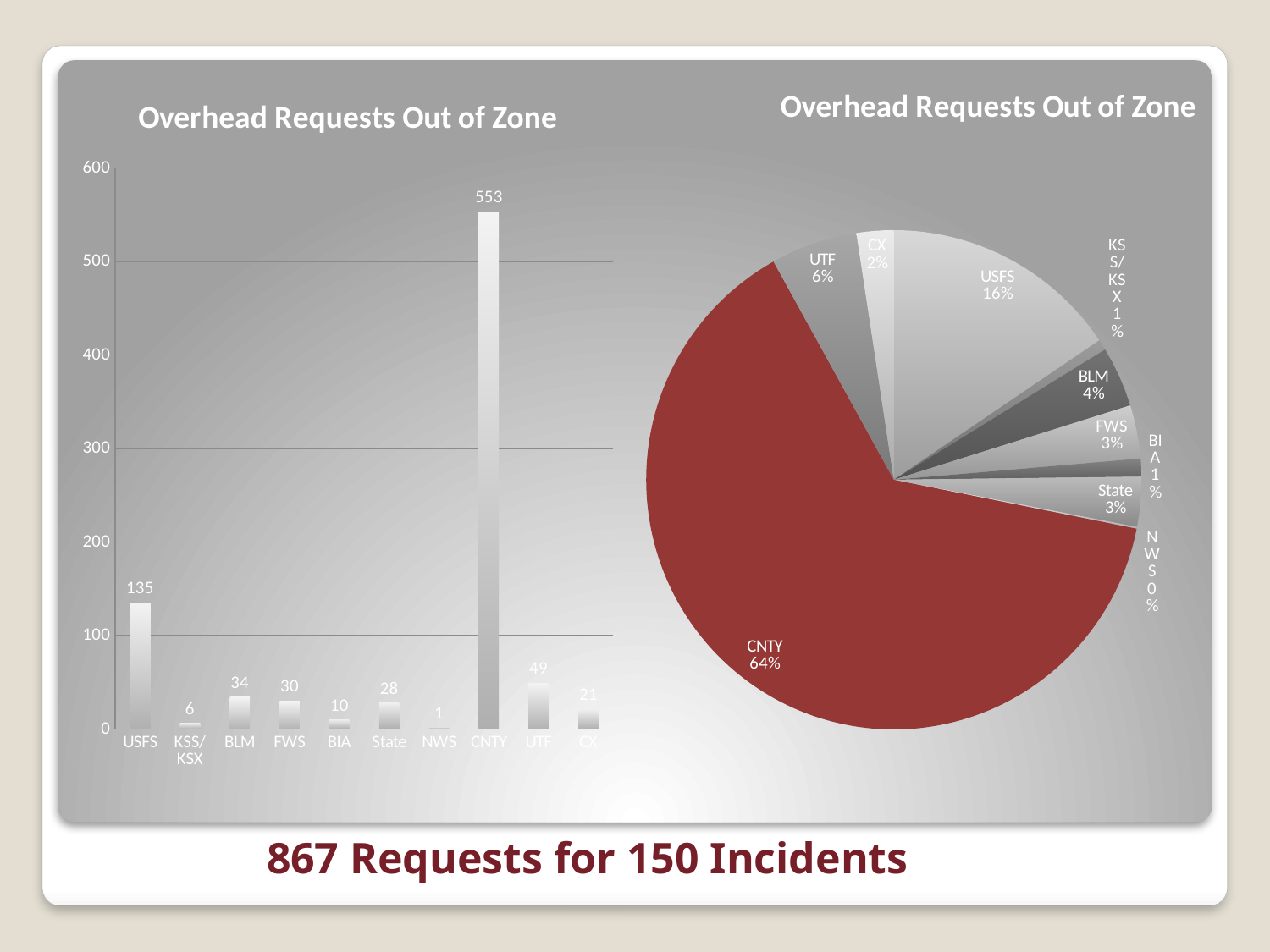
In the bar chart on the left, which is larger, the value for BLM or the value for FWS? BLM How many categories are shown in the bar chart on the left? 10 In the bar chart on the left, which category has the lowest value? NWS In the bar chart on the left, what is the value for UTF? 49 In the bar chart on the left, what is the difference between the values for CNTY and USFS? 418 In the pie chart on the right, what share does USFS have? 16% In the bar chart on the left, which category has the highest value? CNTY In the bar chart on the left, what is the value for USFS? 135 In the pie chart on the right, what share does CNTY have? 64% In the bar chart on the left, what is the value for CNTY? 553 What kind of chart is on the left side of the slide? bar chart What kind of chart is on the right side of the slide? pie chart